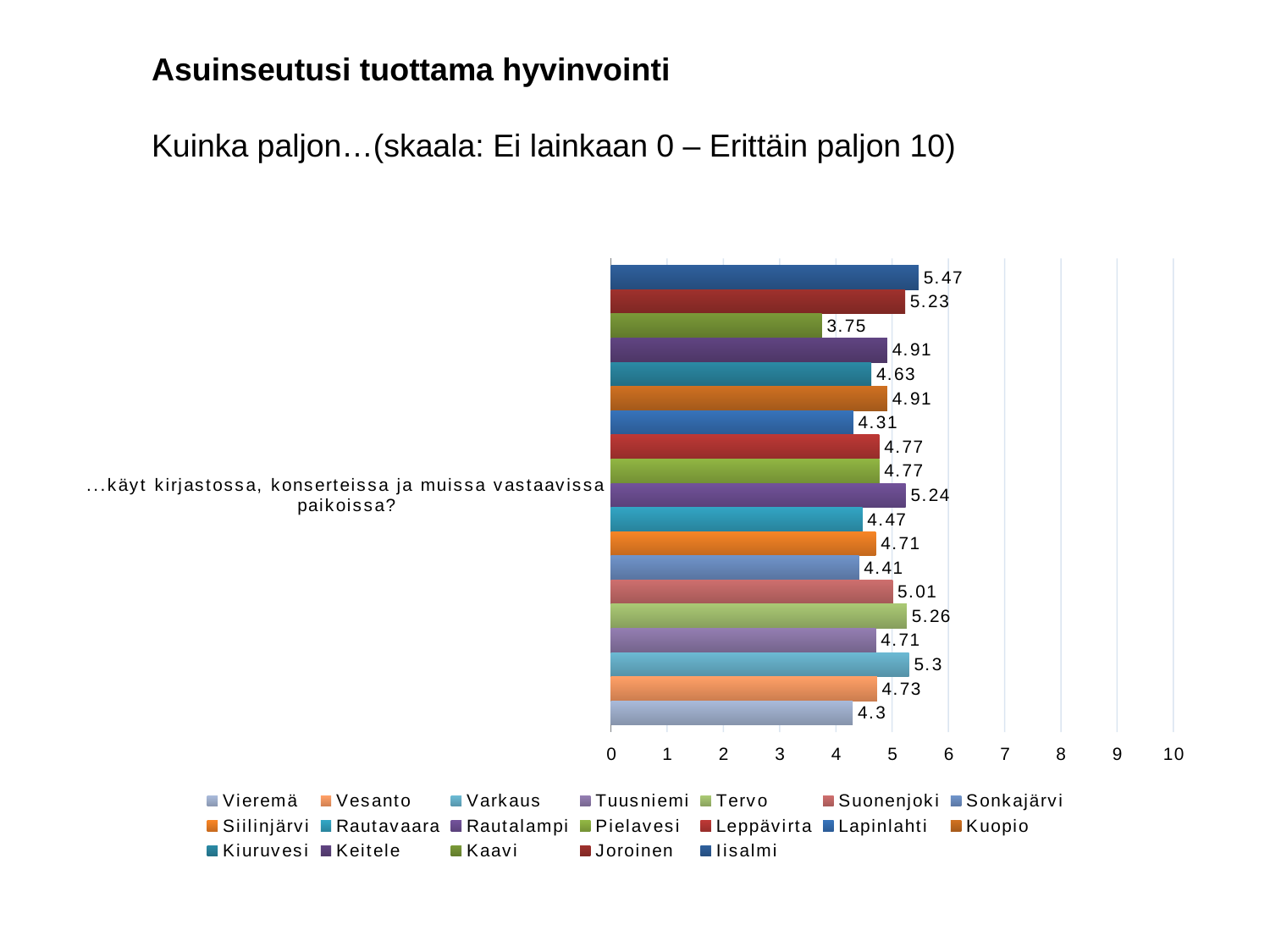
What is the value for Vieremä? 4.3 Which has a larger value, Joroinen or Lapinlahti? Joroinen Is the value for Kaavi greater or less than 4? less What is the difference between the values for Iisalmi and Kaavi? 1.72 Which municipality has the lowest value? Kaavi What is the value for Varkaus? 5.3 What is the value for Suonenjoki? 5.01 What is the value for Kaavi? 3.75 What is the value for Iisalmi? 5.47 Which municipality has the highest value? Iisalmi How many series does the legend list? 19 What kind of chart is shown on the slide? Bar chart